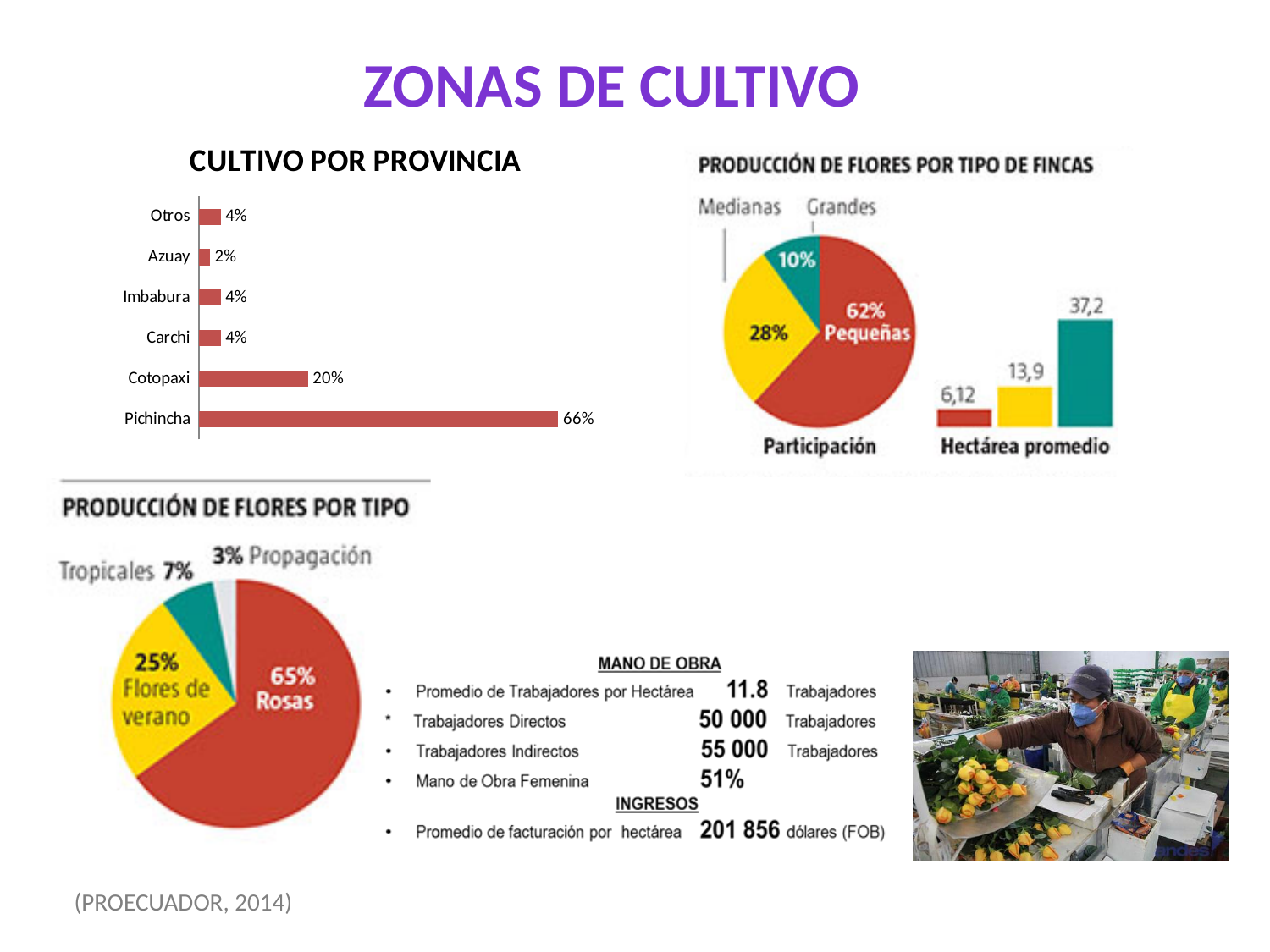
In the 'CULTIVO POR PROVINCIA' chart, what is the value for Cotopaxi? 20% In the 'CULTIVO POR PROVINCIA' chart, what is the difference between Pichincha and Cotopaxi? 46% In the 'CULTIVO POR PROVINCIA' chart, what is the value for Pichincha? 66% In the 'PRODUCCIÓN DE FLORES POR TIPO' pie chart, which is larger, Flores de verano or Tropicales? Flores de verano In the 'CULTIVO POR PROVINCIA' chart, which province has the highest value? Pichincha In the 'CULTIVO POR PROVINCIA' chart, which province has the lowest value? Azuay In the 'PRODUCCIÓN DE FLORES POR TIPO DE FINCAS' pie chart, what share do Pequeñas farms have? 62% What kind of chart is 'CULTIVO POR PROVINCIA'? Bar chart In the 'PRODUCCIÓN DE FLORES POR TIPO' pie chart, what share do Rosas have? 65% In the 'CULTIVO POR PROVINCIA' chart, how many categories are shown? 6 In the 'PRODUCCIÓN DE FLORES POR TIPO DE FINCAS' chart, which farm type has the smallest Hectárea promedio? Pequeñas In the 'PRODUCCIÓN DE FLORES POR TIPO DE FINCAS' chart, what is the Hectárea promedio for Grandes farms? 37,2